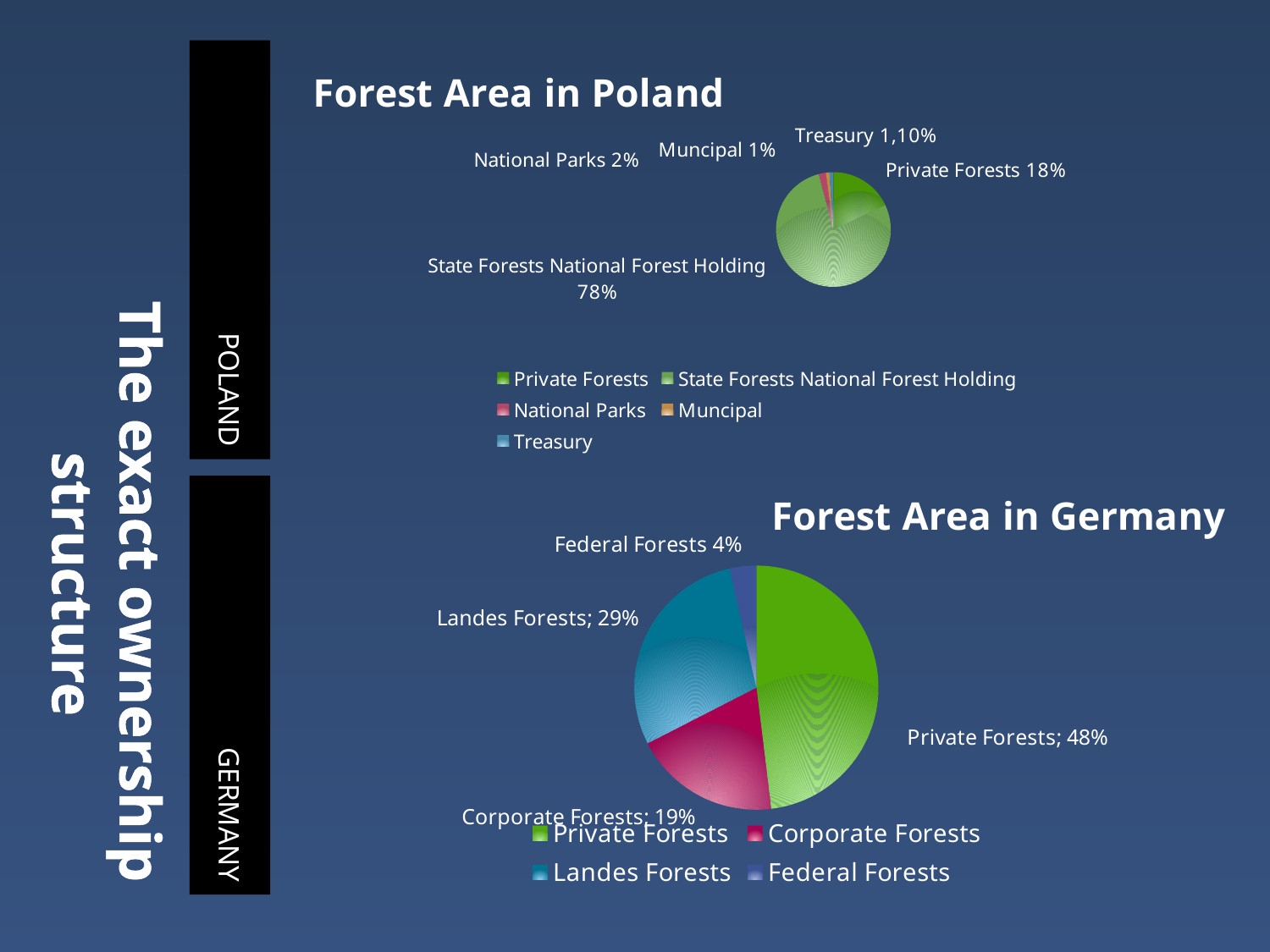
In the Forest Area in Poland chart, what is the difference between the State Forests National Forest Holding share and the Private Forests share? 60% What kind of chart is the Forest Area in Germany chart? Pie chart In the Forest Area in Germany chart, which category has the smallest slice? Federal Forests In the Forest Area in Germany chart, which is larger, Private Forests or Landes Forests? Private Forests In the Forest Area in Poland chart, how many entries does the legend list? 5 In the Forest Area in Poland chart, what share is labelled for State Forests National Forest Holding? 78% In the Forest Area in Poland chart, what value is labelled for Treasury? 1,10% In the Forest Area in Poland chart, which category has the largest slice? State Forests National Forest Holding In the Forest Area in Germany chart, how many categories does the legend list? 4 In the Forest Area in Germany chart, what share is labelled for Corporate Forests? 19% In the Forest Area in Poland chart, what share is labelled for Private Forests? 18% In the Forest Area in Germany chart, what share is labelled for Landes Forests? 29%